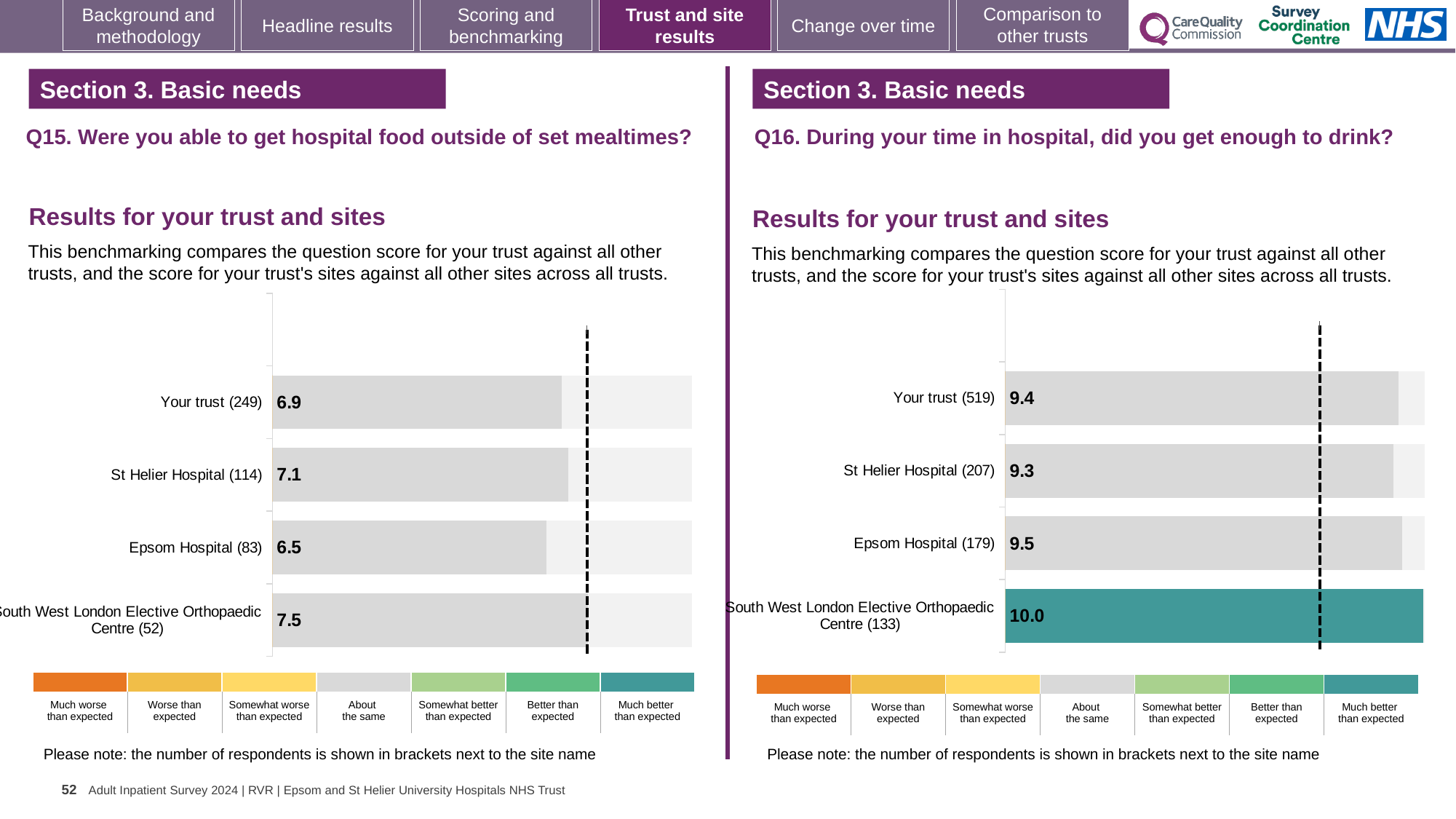
In the Q16 chart (right), what is the score for St Helier Hospital (207)? 9.3 In the Q16 chart (right), which is larger, the score for Your trust (519) or Epsom Hospital (179)? Epsom Hospital (179) In the Q15 chart (left), which site or trust has the highest score? South West London Elective Orthopaedic Centre (52) How many bars are shown in the Q15 chart (left)? 4 In the Q16 chart (right), which site or trust has the lowest score? St Helier Hospital (207) In the Q15 chart (left), which site or trust has the lowest score? Epsom Hospital (83) In the Q16 chart (right), what is the score for South West London Elective Orthopaedic Centre (133)? 10.0 In the Q16 chart (right), what is the difference between the scores for South West London Elective Orthopaedic Centre (133) and Your trust (519)? 0.6 What type of chart is used for the Q16 results (right)? Bar chart In the Q15 chart (left), what is the score for Your trust (249)? 6.9 In the Q15 chart (left), what is the score for Epsom Hospital (83)? 6.5 In the Q15 chart (left), what is the difference between the scores for St Helier Hospital (114) and Epsom Hospital (83)? 0.6